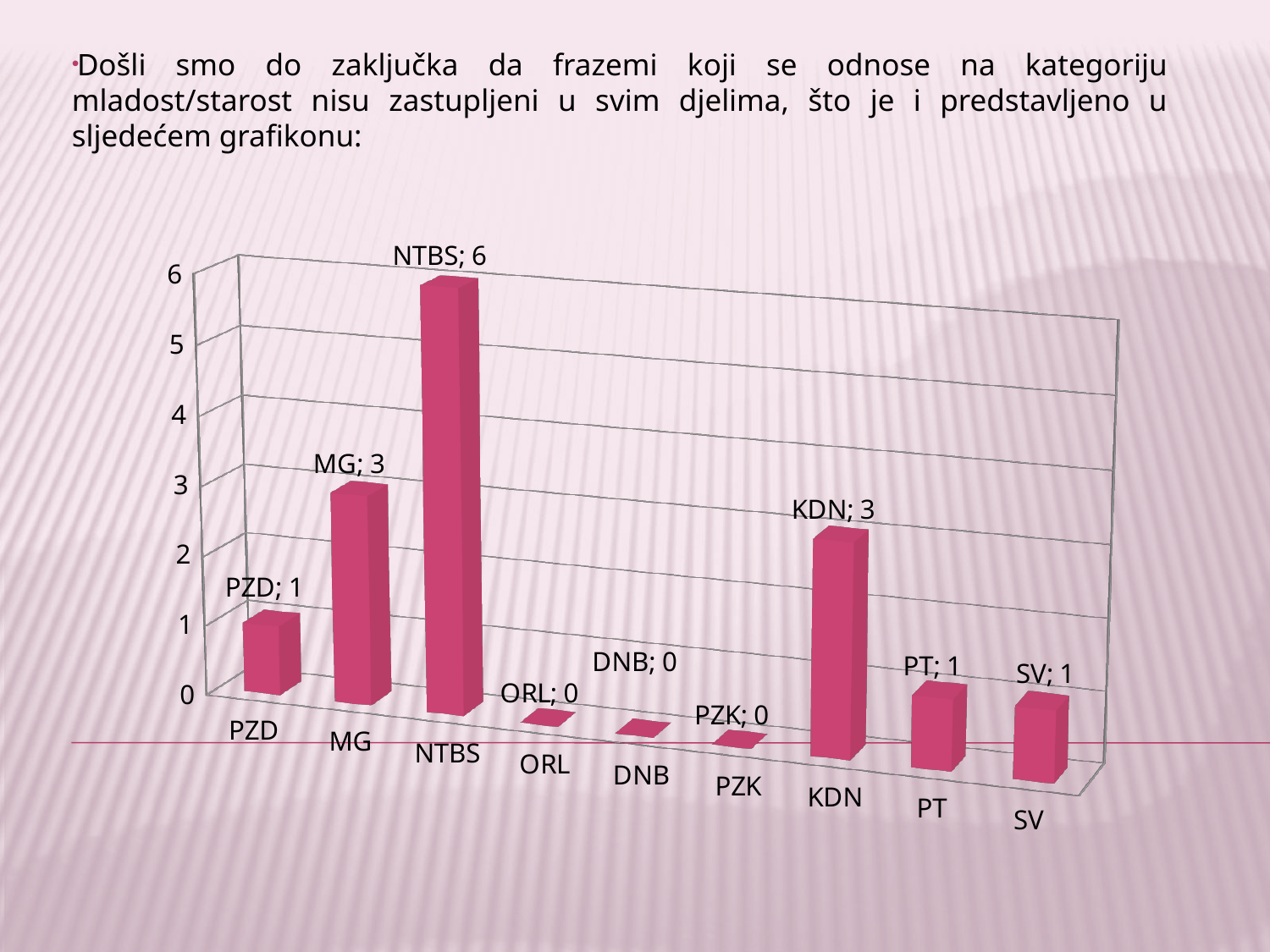
Which is larger, the value for MG or the value for PT? MG What is the difference between the values for NTBS and MG? 3 Which category has the highest value? NTBS What is the value for KDN? 3 What is the value for DNB? 0 How many categories are shown on the x axis? 9 What is the value for PZD? 1 What is the highest value shown on the vertical axis? 6 Is the value for NTBS greater or less than 5? greater What is the value for NTBS? 6 What kind of chart is shown on the slide? bar chart How many categories have a value of 0? 3